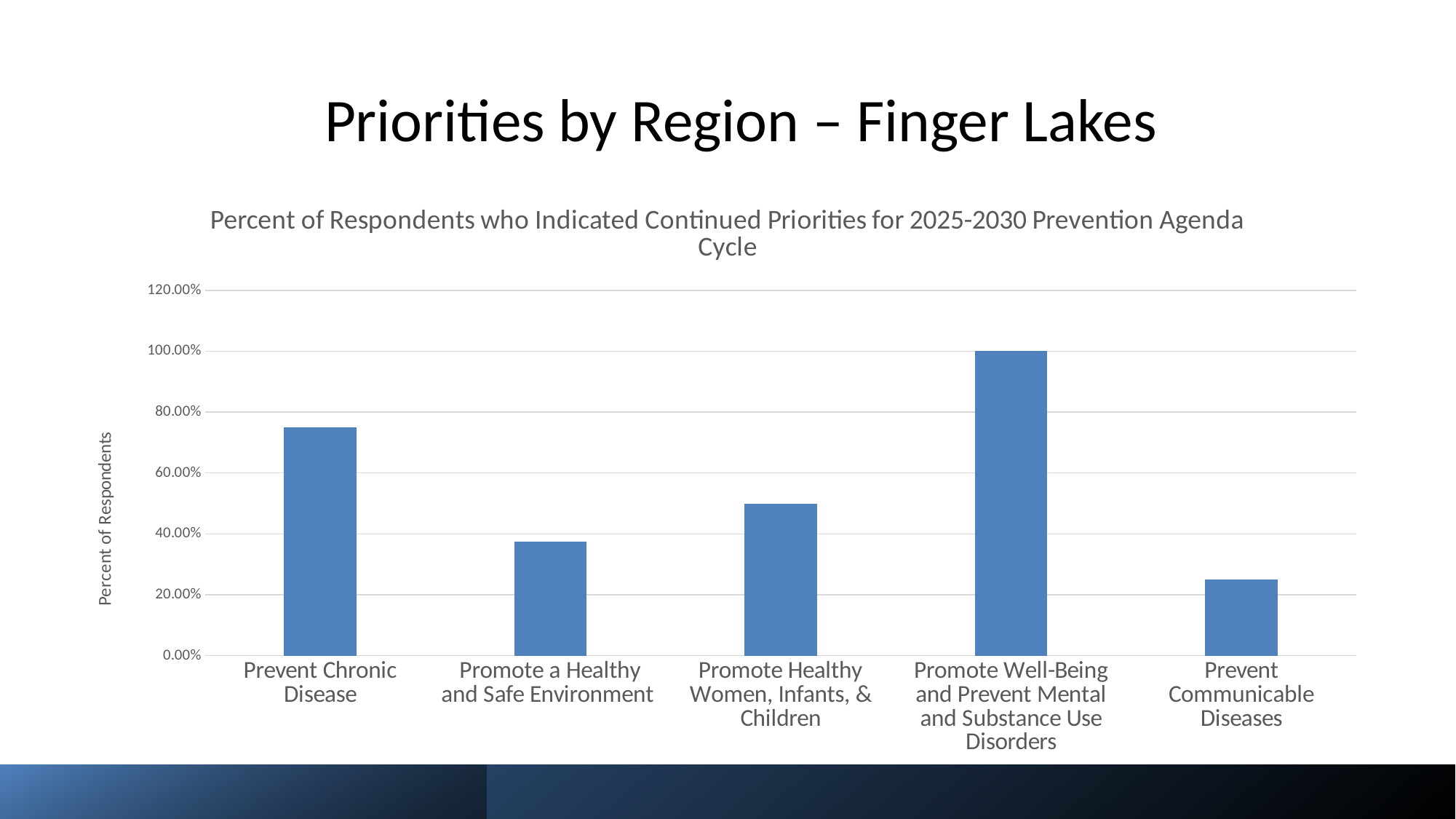
Which priority has the highest percent of respondents? Promote Well-Being and Prevent Mental and Substance Use Disorders Is the value for Prevent Communicable Diseases greater or less than 20.00%? greater What is the percent of respondents for Promote Well-Being and Prevent Mental and Substance Use Disorders? 100.00% How many priority categories are shown on the chart? 5 What kind of chart is shown on the slide? bar chart Which is larger, the value for Prevent Chronic Disease or the value for Promote Healthy Women, Infants, & Children? Prevent Chronic Disease Is the value for Promote Healthy Women, Infants, & Children greater or less than 60.00%? less What is the title of the chart? Percent of Respondents who Indicated Continued Priorities for 2025-2030 Prevention Agenda Cycle Is the value for Promote a Healthy and Safe Environment greater or less than 40.00%? less Which priority has the lowest percent of respondents? Prevent Communicable Diseases What is the label on the vertical axis of the chart? Percent of Respondents